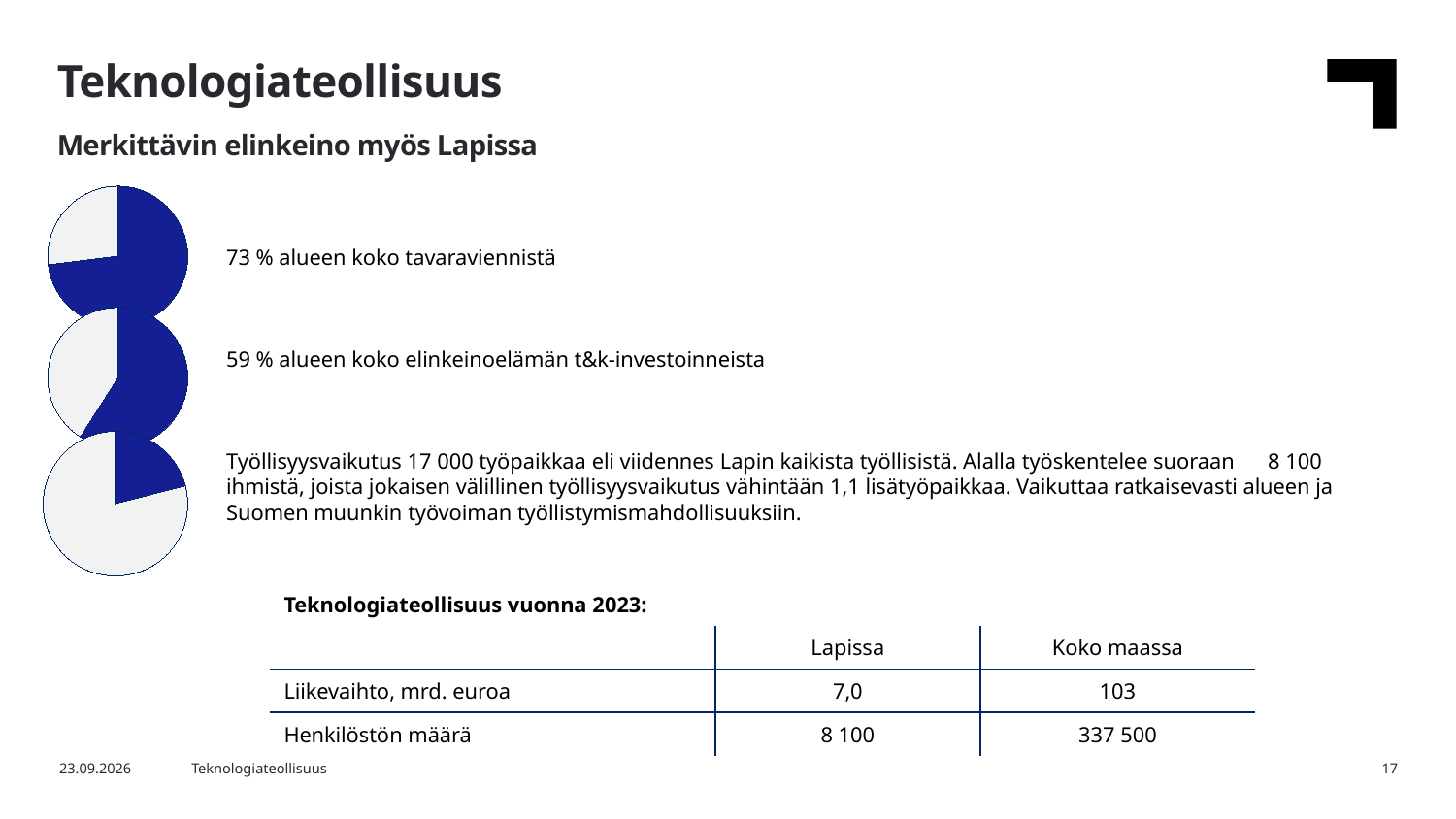
Which pie chart has the largest highlighted slice: the top, middle or bottom one? Top What colour is the highlighted slice in each of the pie charts? Dark blue What kind of charts are shown on the left side of the slide? Pie charts How many pie charts are on the slide? 3 In the top pie chart, what share of the region's total goods exports (tavaravienti) does the highlighted slice represent? 73 % Is the highlighted slice of the bottom pie chart greater or less than 50 % of the pie? less What is the subtitle of the slide above the pie charts? Merkittävin elinkeino myös Lapissa What is the difference in percentage points between the shares shown by the top pie chart (73 %) and the middle pie chart (59 %)? 14 percentage points In the middle pie chart, what share of the region's business R&D investments (t&k-investoinnit) does the highlighted slice represent? 59 % Is the highlighted slice of the top pie chart larger or smaller than the highlighted slice of the middle pie chart? Larger Which pie chart has the smallest highlighted slice: the top, middle or bottom one? Bottom